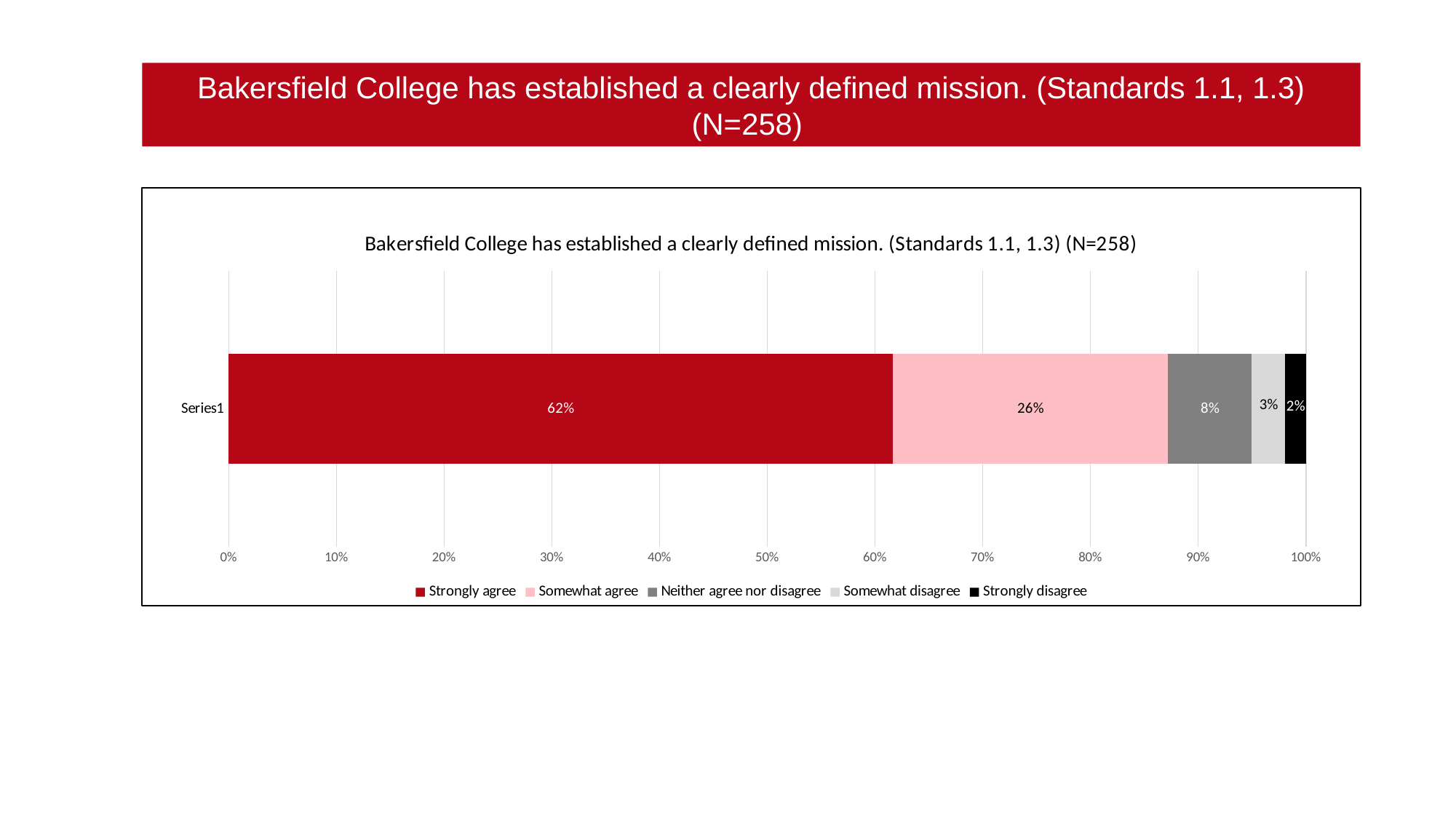
What is the difference between the "Strongly agree" and "Somewhat agree" percentages? 36% What percentage of respondents selected "Strongly disagree"? 2% What percentage of respondents selected "Neither agree nor disagree"? 8% Which response option has the largest share? Strongly agree What percentage of respondents selected "Somewhat disagree"? 3% What percentage of respondents selected "Strongly agree"? 62% How many series does the legend list? 5 What is the combined percentage of "Strongly agree" and "Somewhat agree" responses? 88% What kind of chart is shown on the slide? Stacked bar chart What percentage of respondents selected "Somewhat agree"? 26% Which response option has the smallest share? Strongly disagree Which is larger, the share for "Neither agree nor disagree" or the share for "Somewhat disagree"? Neither agree nor disagree